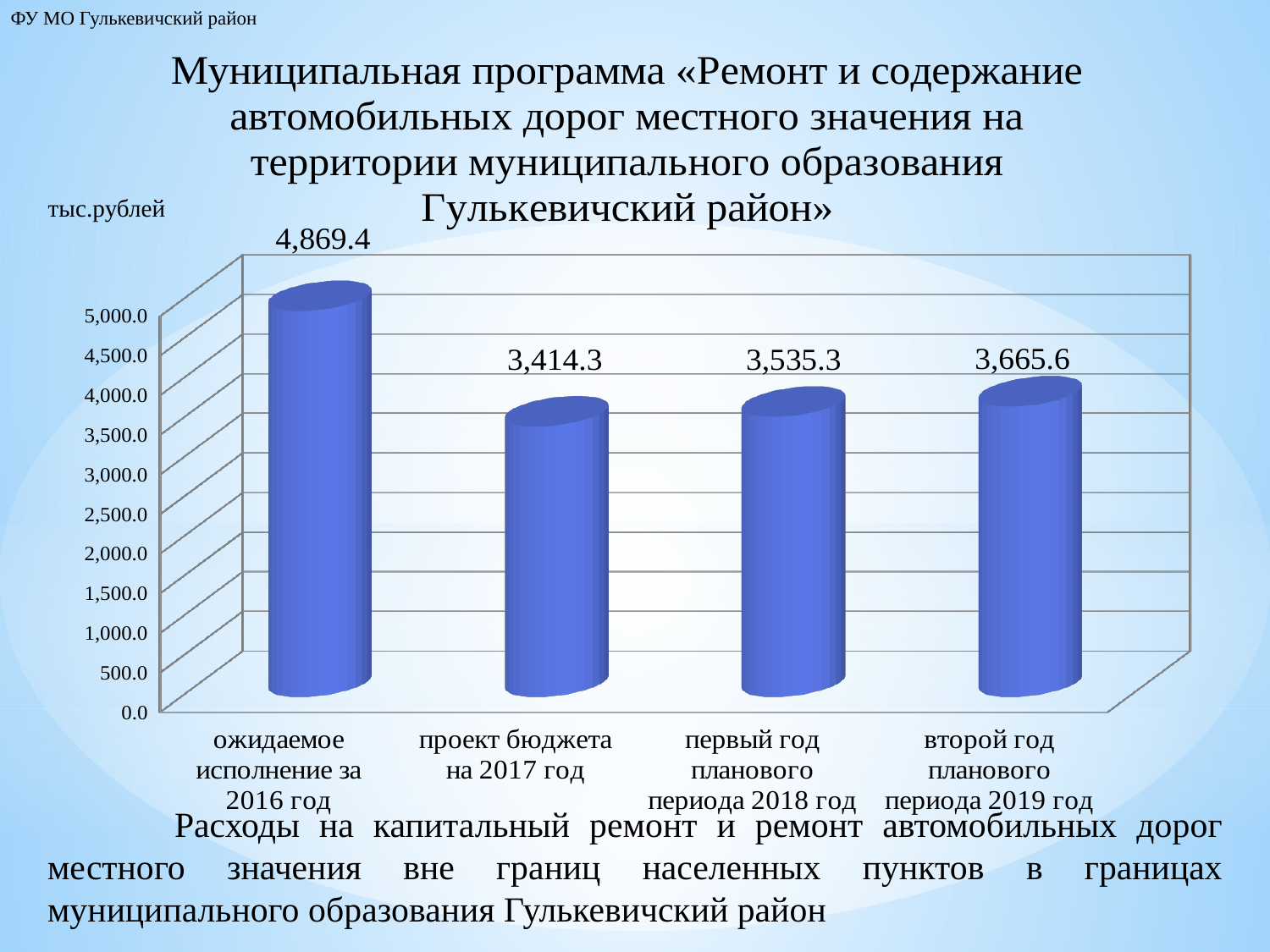
What is the value for 'проект бюджета на 2017 год'? 3,414.3 What is the difference between the values for 2016 and 2017? 1,455.1 Do the values rise or fall from 2017 to 2019? rise What is the value for 'второй год планового периода 2019 год'? 3,665.6 Which category has the highest value? ожидаемое исполнение за 2016 год How many categories are shown on the chart? 4 Which category has the lowest value? проект бюджета на 2017 год What is the value for 'первый год планового периода 2018 год'? 3,535.3 What is the value for 'ожидаемое исполнение за 2016 год'? 4,869.4 What kind of chart is shown on the slide? bar chart What is the difference between the values for 2019 and 2018? 130.3 Which is larger, the value for 2018 or the value for 2019? 2019